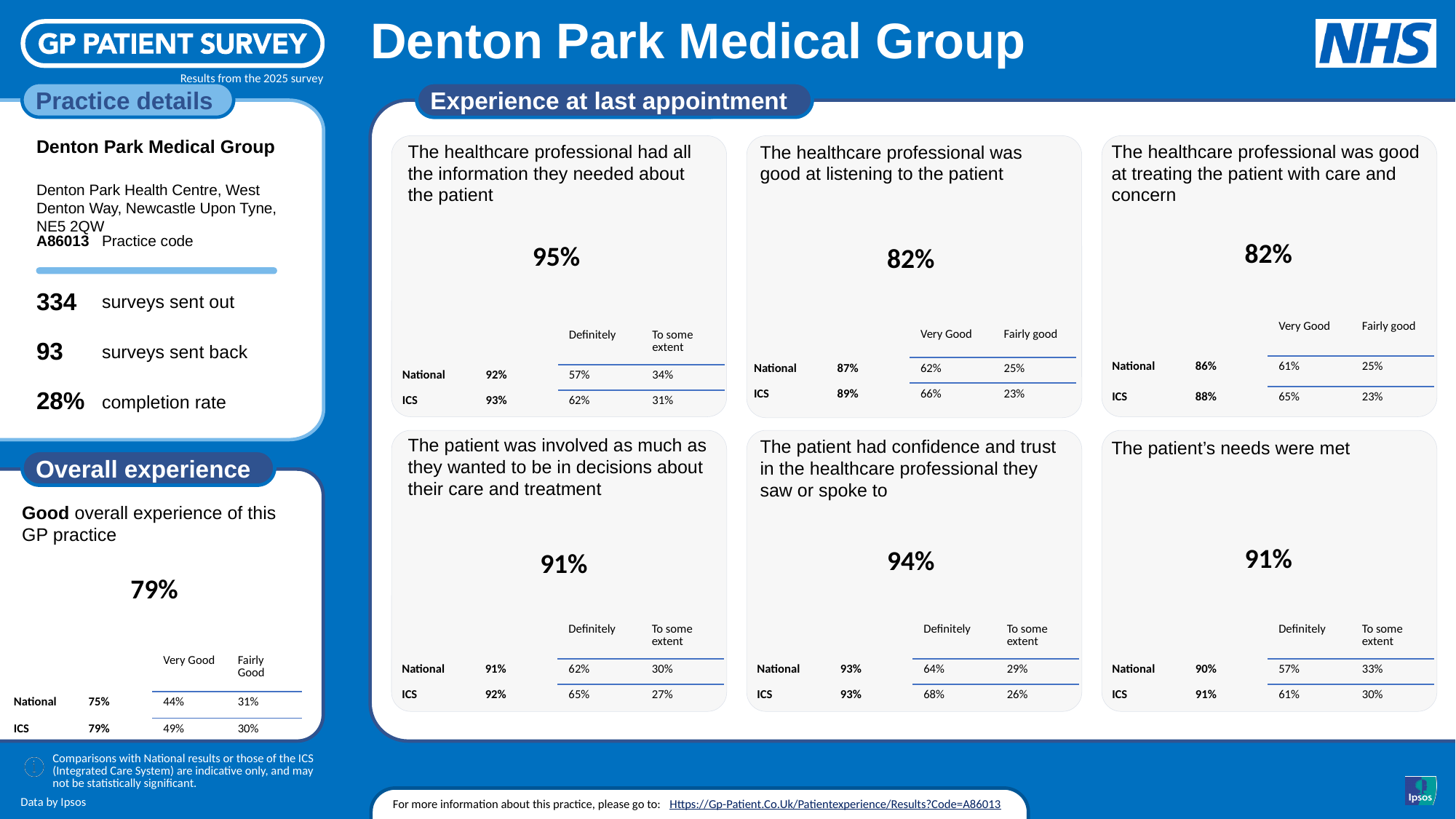
In the 'The patient had confidence and trust in the healthcare professional they saw or spoke to' panel, what is the practice's percentage? 94% In the 'The patient's needs were met' panel, what is the ICS 'Definitely' percentage? 61% How many question panels are shown under the 'Experience at last appointment' heading? 6 Across the six 'Experience at last appointment' panels, which question has the highest practice percentage? The healthcare professional had all the information they needed about the patient In the 'The healthcare professional was good at treating the patient with care and concern' panel, what is the National 'Very Good' percentage? 61% In the 'Good overall experience of this GP practice' panel, which is larger: the practice's percentage or the National percentage? The practice's percentage In the 'Good overall experience of this GP practice' panel, what is the practice's percentage? 79% In the 'The healthcare professional was good at listening to the patient' panel, what is the difference between the National percentage and the practice's percentage? 5% In the 'The healthcare professional was good at listening to the patient' panel, what is the ICS percentage? 89% In the 'The healthcare professional had all the information they needed about the patient' panel, what is the practice's percentage? 95% In the 'Good overall experience of this GP practice' panel, what is the National percentage? 75% In the 'The patient was involved as much as they wanted to be in decisions about their care and treatment' panel, what is the difference between the ICS percentage and the National percentage? 1%